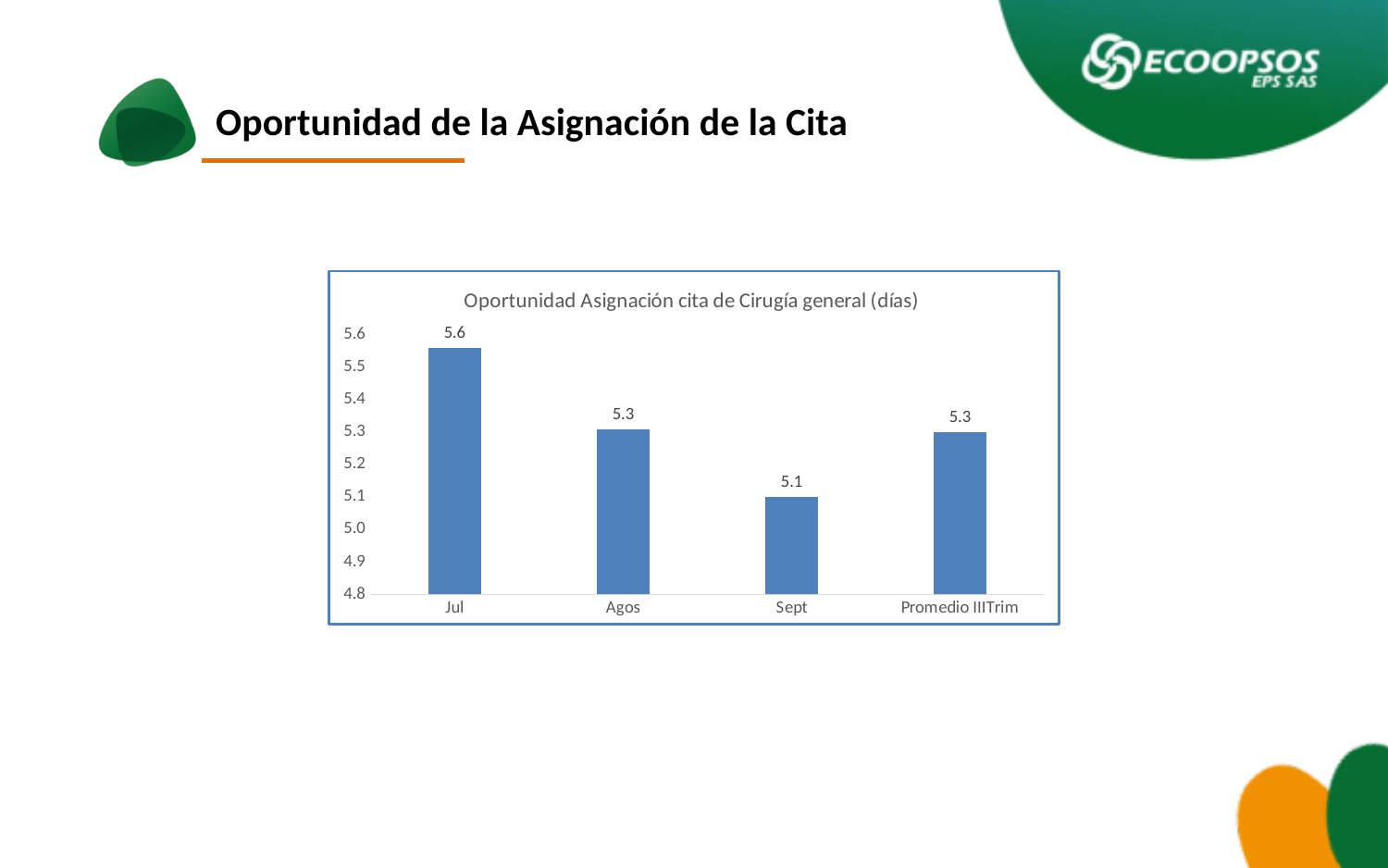
What is the difference between the values for Jul and Sept? 0.5 What kind of chart is shown on the slide? bar chart Which category has the highest value? Jul What is the value for Promedio IIITrim? 5.3 How many categories are shown on the x axis? 4 What is the value for Sept? 5.1 What is the difference between the values for Agos and Sept? 0.2 What is the value for Jul? 5.6 Which is larger, the value for Jul or the value for Agos? Jul Which category has the lowest value? Sept Is the value for Sept greater or less than 5.2? less What is the title of the chart? Oportunidad Asignación cita de Cirugía general (días)